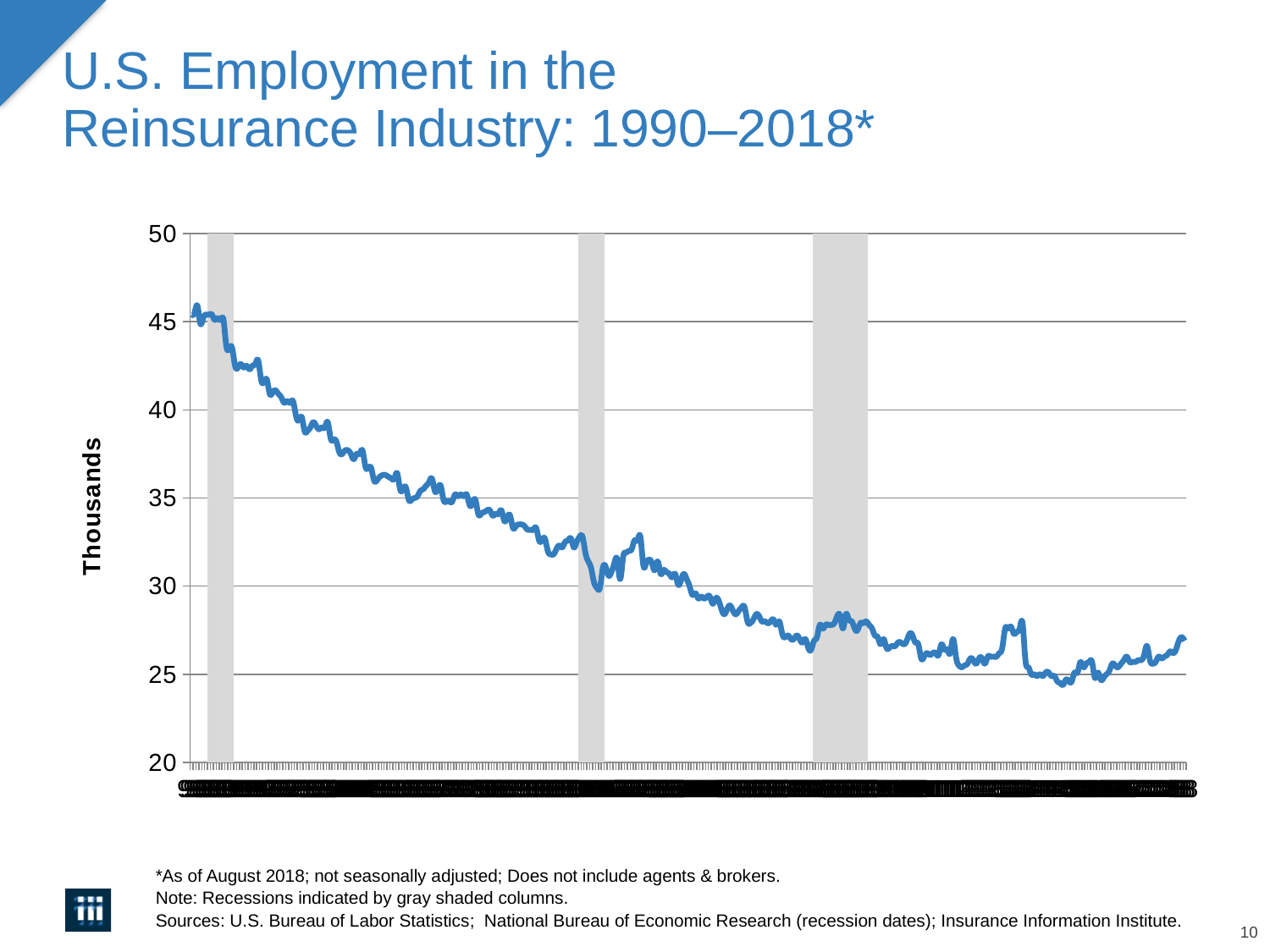
What kind of chart is shown on the slide? line chart What is the highest value shown on the vertical axis? 50 Is the value at the end of the line (right end) greater or less than 30? less Is the value at the end of the line (right end) greater or less than 25? greater Is the value at the start of the line (left end) greater or less than 40? greater What is the title of the chart? U.S. Employment in the Reinsurance Industry: 1990–2018* Does the employment line generally rise or fall from left to right across the chart? fall Which end of the line is higher, the left end or the right end? left end What is the label on the vertical axis of the chart? Thousands